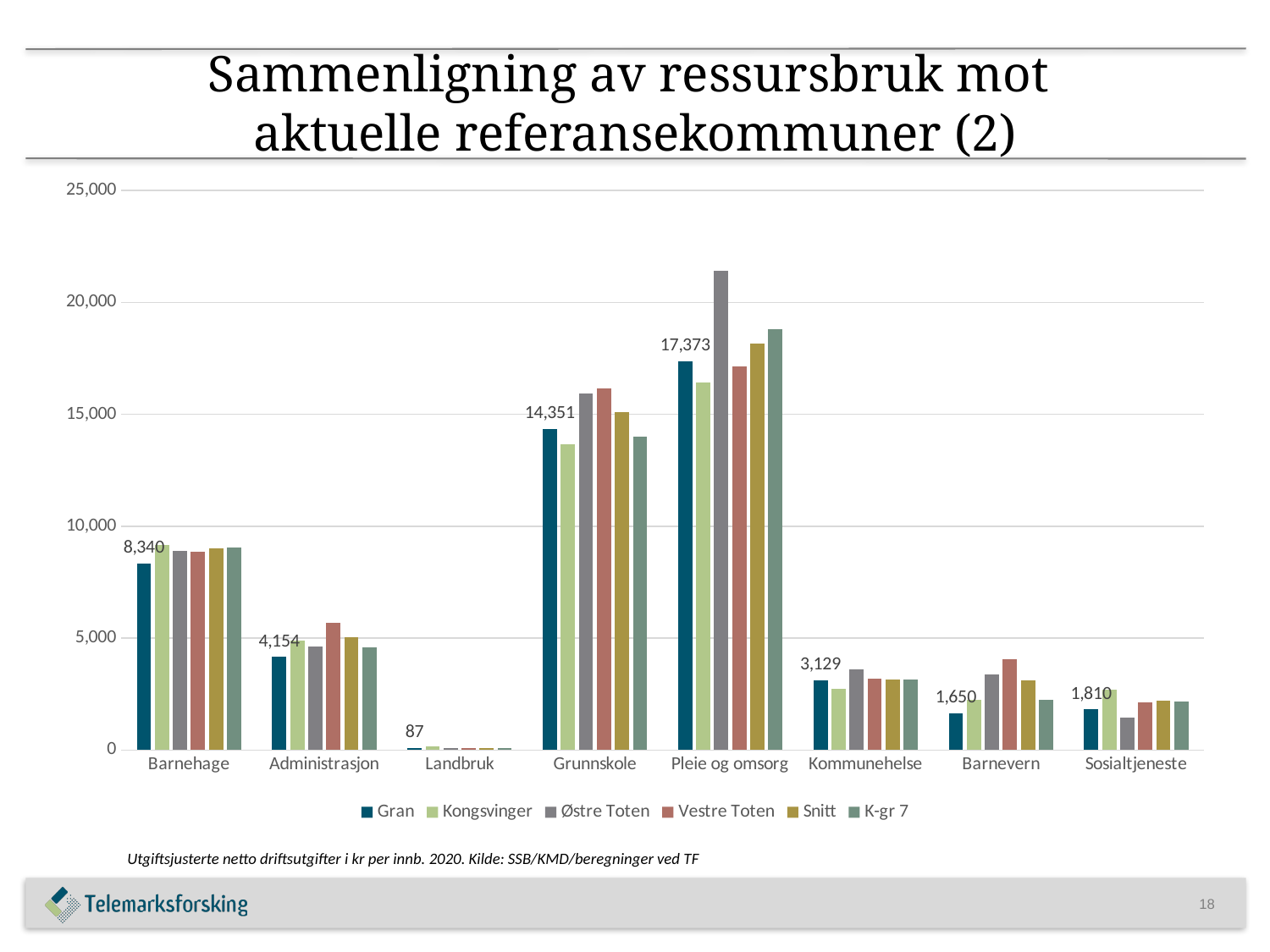
Among the labelled Gran values, which category has the highest value? Pleie og omsorg What is the value for Gran in the Barnehage category? 8,340 What kind of chart is shown on the slide? Bar chart Which is larger for Gran: the value for Kommunehelse or the value for Barnevern? Kommunehelse What is the value for Gran in the Pleie og omsorg category? 17,373 Is the value for Vestre Toten in Administrasjon greater or less than 5,000? greater How many categories are shown on the x axis? 8 Among the labelled Gran values, which category has the lowest value? Landbruk What is the difference between Gran's value for Pleie og omsorg and Gran's value for Grunnskole? 3,022 How many series does the legend list? 6 Is the value for Østre Toten in Pleie og omsorg greater or less than 20,000? greater What is the value for Gran in the Landbruk category? 87